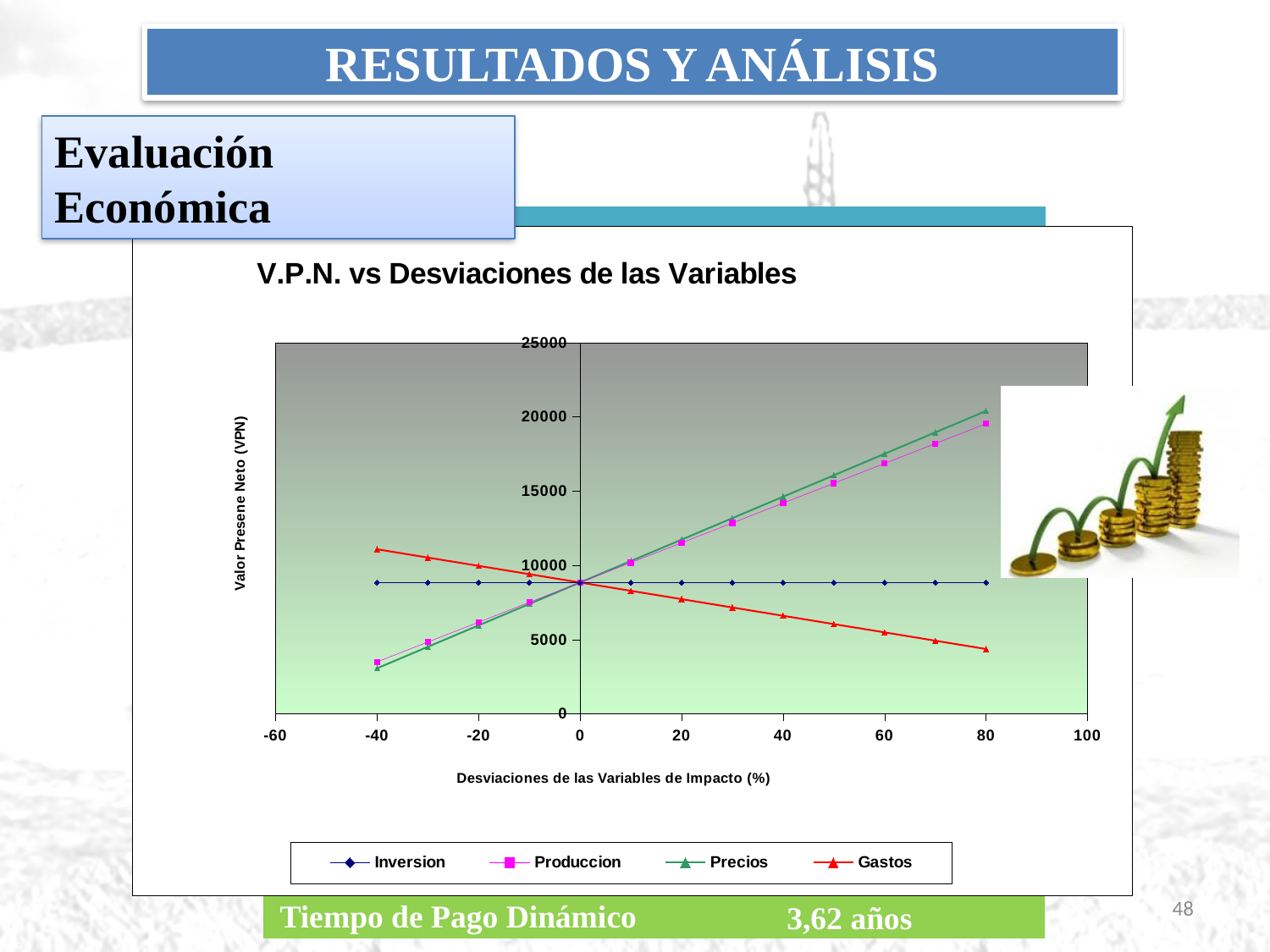
How many series does the legend list? 4 Does the Precios series rise or fall as the deviation increases along the x axis? rise What is the title of the chart? V.P.N. vs Desviaciones de las Variables Does the Gastos series rise or fall as the deviation increases along the x axis? fall Is the value for Gastos at a deviation of -40 greater or less than 10000? greater Is the value for Precios at a deviation of 80 greater or less than 15000? greater Which series is drawn in red in the chart? Gastos Is the value for Gastos at a deviation of 80 greater or less than 5000? less At a deviation of -40, which series has the larger value, Gastos or Produccion? Gastos What kind of chart is shown on the slide? line chart At a deviation of 80, which series has the larger value, Precios or Gastos? Precios